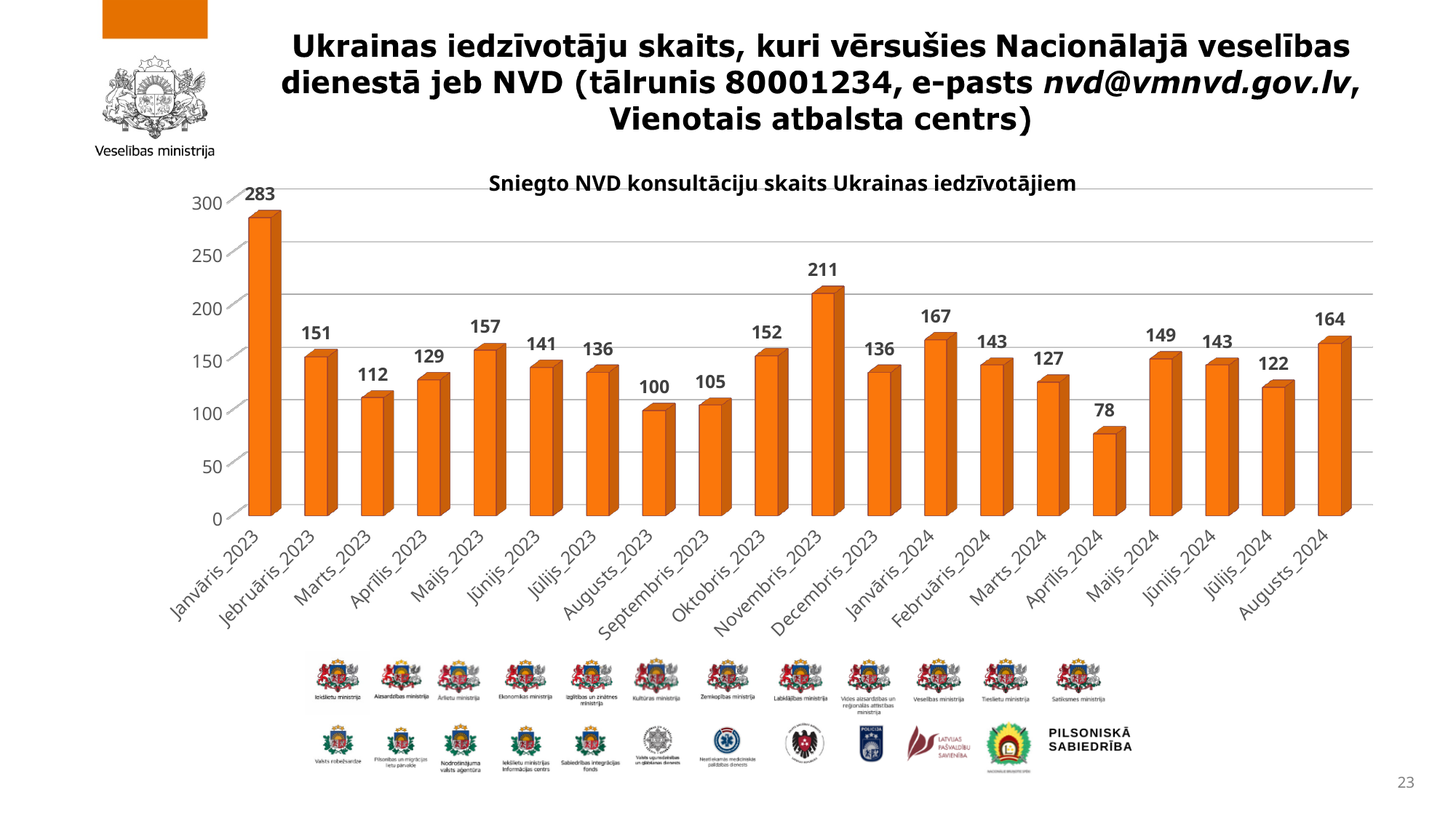
What is the value for Augusts_2024? 164 What is the difference between the values for Janvāris_2023 and Februāris_2023? 132 What kind of chart is shown on the slide? bar chart Which month has the lowest value? Aprīlis_2024 What is the title of the chart? Sniegto NVD konsultāciju skaits Ukrainas iedzīvotājiem How many months are shown on the x axis? 20 What is the difference between the values for Novembris_2023 and Decembris_2023? 75 Is the value for Oktobris_2023 greater or less than 100? greater What is the value for Aprīlis_2024? 78 What is the value for Novembris_2023? 211 Which is larger, the value for Maijs_2023 or the value for Maijs_2024? Maijs_2023 Which month has the highest value? Janvāris_2023